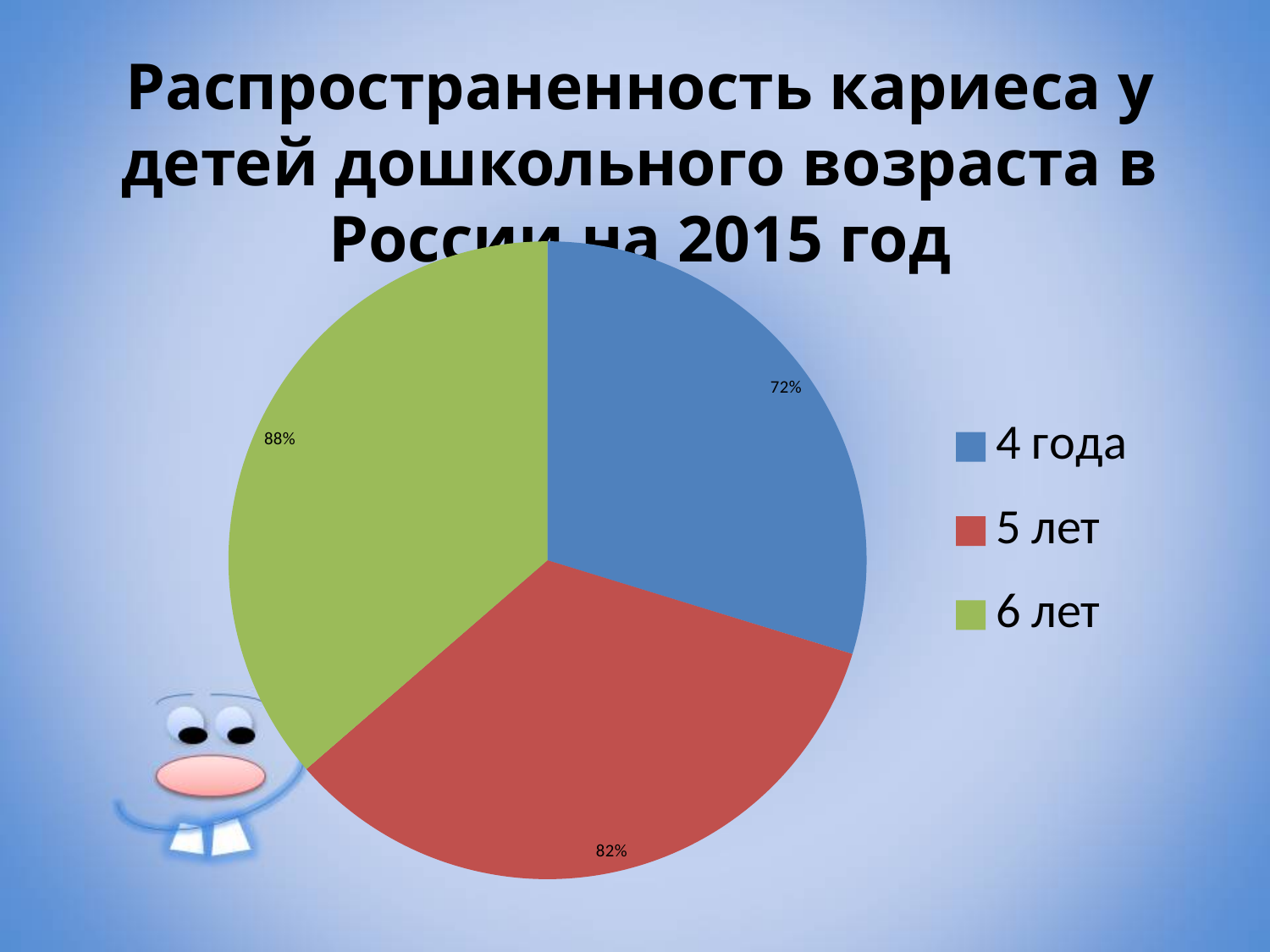
What value is shown for the 5 лет slice? 82% Which age group has the highest value? 6 лет Which age group has the lowest value? 4 года How many slices does the pie chart have? 3 What is the difference between the values for 5 лет and 4 года? 10% What colour is the slice for 6 лет? green How many entries does the legend list? 3 What value is shown for the 4 года slice? 72% What is the difference between the values for 6 лет and 4 года? 16% What kind of chart is shown on the slide? pie chart What value is shown for the 6 лет slice? 88% Which is larger, the value for 5 лет or the value for 4 года? 5 лет